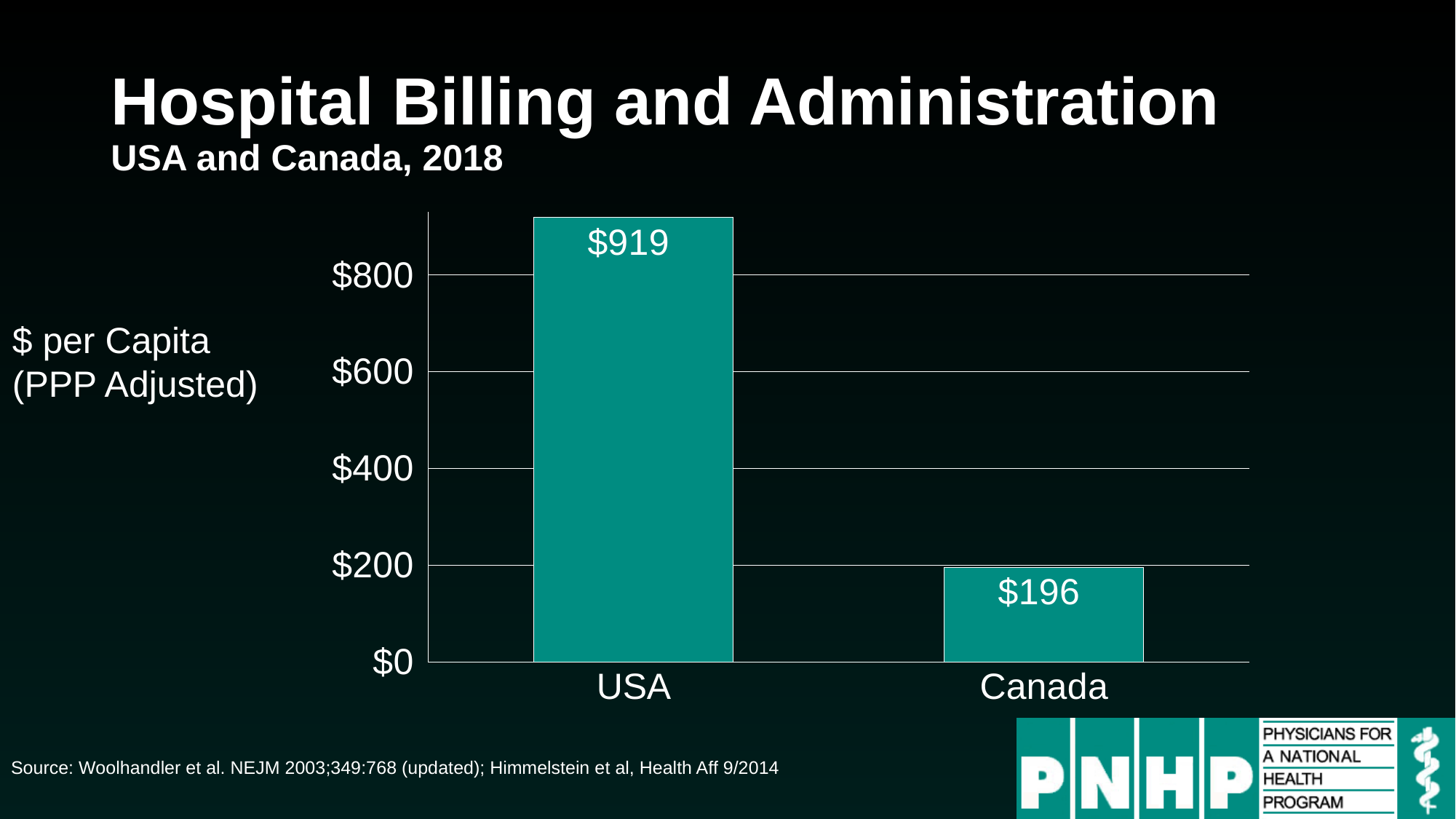
What is the difference between the USA and Canada values? $723 What is the value for USA? $919 Is the value for USA greater or less than $800? greater What unit is shown on the y axis label? $ per Capita (PPP Adjusted) What is the value for Canada? $196 Is the value for Canada greater or less than $200? less How many countries are shown in the chart? 2 Which country has the highest hospital billing and administration cost per capita? USA Which country has the lowest hospital billing and administration cost per capita? Canada What is the title of the chart? Hospital Billing and Administration What kind of chart is shown on the slide? bar chart Which is larger, the value for USA or the value for Canada? USA